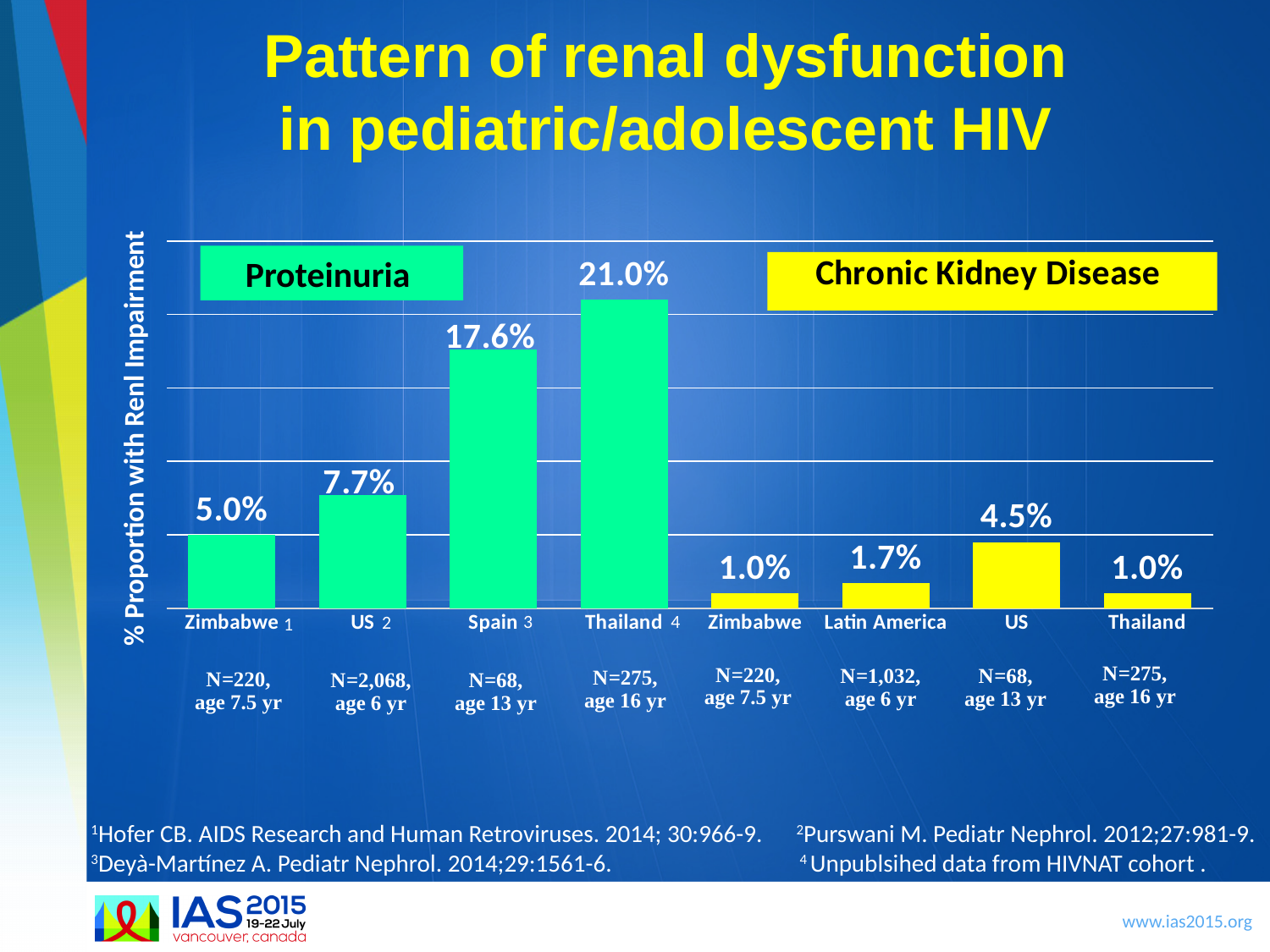
Which country has the highest proteinuria proportion? Thailand What type of chart is shown on the slide? Bar chart How many bars are plotted in the chart? 8 Which category has the highest chronic kidney disease proportion? US What is the difference between the proteinuria values for Thailand and Spain? 3.4% What is the proteinuria value for Thailand? 21.0% What is the difference between the proteinuria value for the US and the chronic kidney disease value for the US? 3.2% What is the chronic kidney disease value for Latin America? 1.7% What is the proteinuria value for Spain? 17.6% Which country has the lowest proteinuria proportion? Zimbabwe What is the chronic kidney disease value for the US? 4.5% Which is larger, the proteinuria value for the US or the proteinuria value for Zimbabwe? US